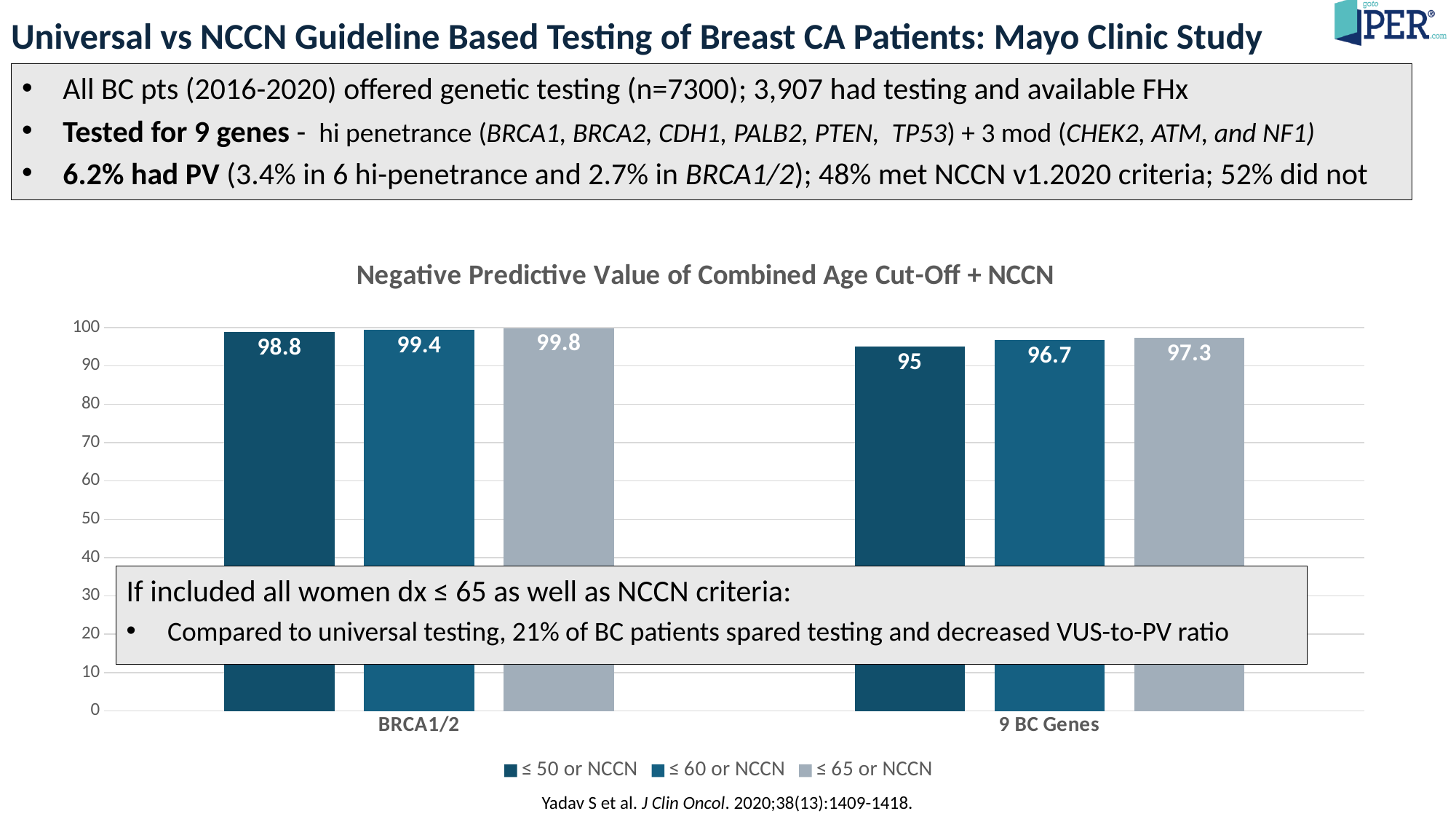
What is the value for ≤ 65 or NCCN in the 9 BC Genes category? 97.3 Which is larger: the ≤ 60 or NCCN value for BRCA1/2 or the ≤ 60 or NCCN value for 9 BC Genes? BRCA1/2 What kind of chart is shown on the slide? Bar chart Which series has the highest value in the BRCA1/2 category? ≤ 65 or NCCN What is the difference between the ≤ 65 or NCCN value and the ≤ 50 or NCCN value in the 9 BC Genes category? 2.3 How many series does the legend list? 3 Is the value for ≤ 50 or NCCN in the 9 BC Genes category greater or less than 90? greater What is the value for ≤ 60 or NCCN in the 9 BC Genes category? 96.7 What is the value for ≤ 50 or NCCN in the BRCA1/2 category? 98.8 Which series has the lowest value in the 9 BC Genes category? ≤ 50 or NCCN How many categories are shown on the x axis? 2 What is the title of the chart? Negative Predictive Value of Combined Age Cut-Off + NCCN